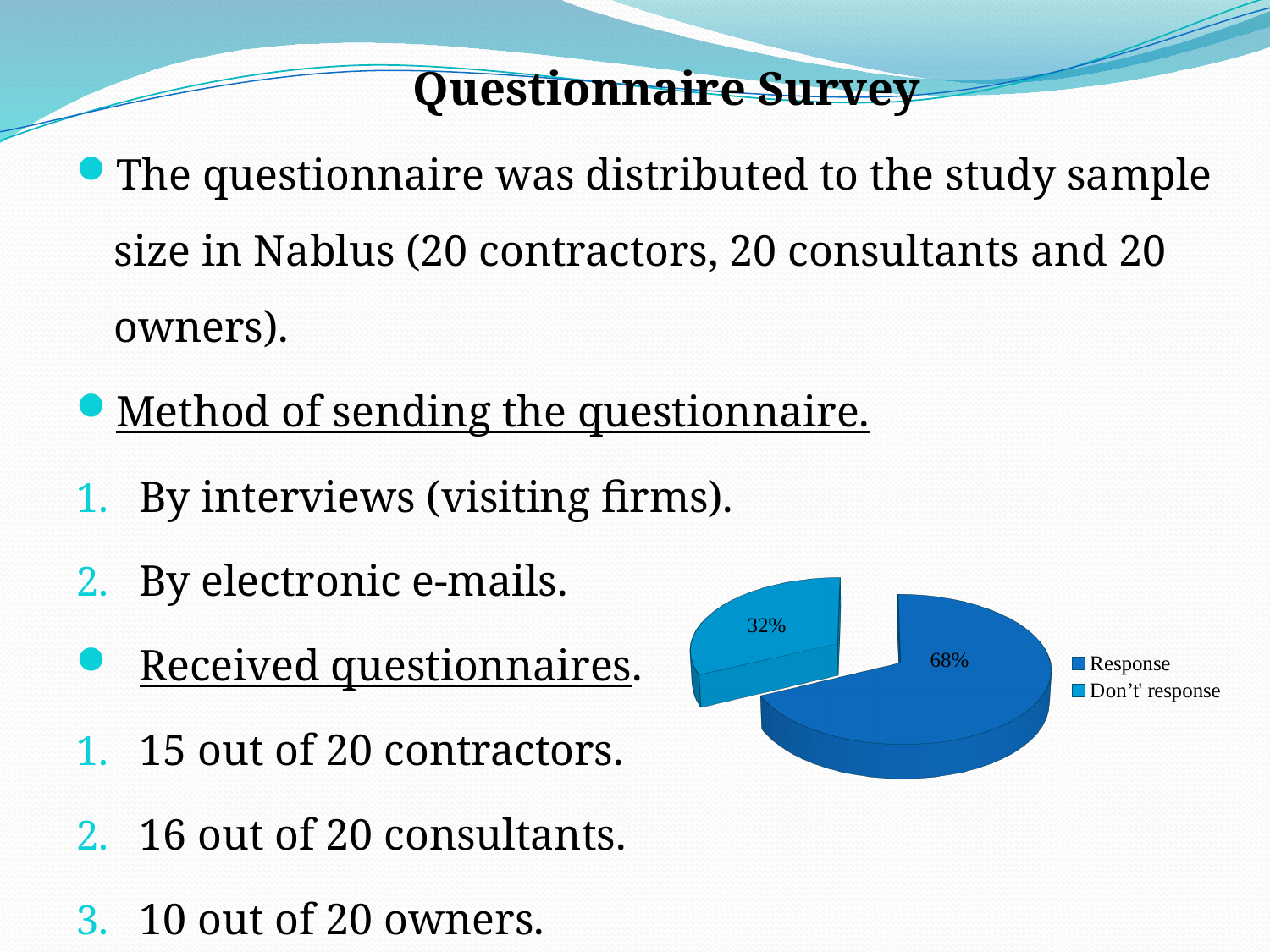
What share of the pie does the Response slice represent? 68% What is the difference in percentage points between the Response and Don't response slices? 36 What kind of chart is shown on the slide? pie chart Which slice of the pie is the largest? Response Is the Response slice greater or less than 50% of the pie? greater How many entries does the legend list? 2 What are the two legend entries of the pie chart? Response and Don't response Which is larger, the Response slice or the Don't response slice? Response What share of the pie does the Don't response slice represent? 32% How many slices does the pie chart have? 2 Which slice of the pie is the smallest? Don't response